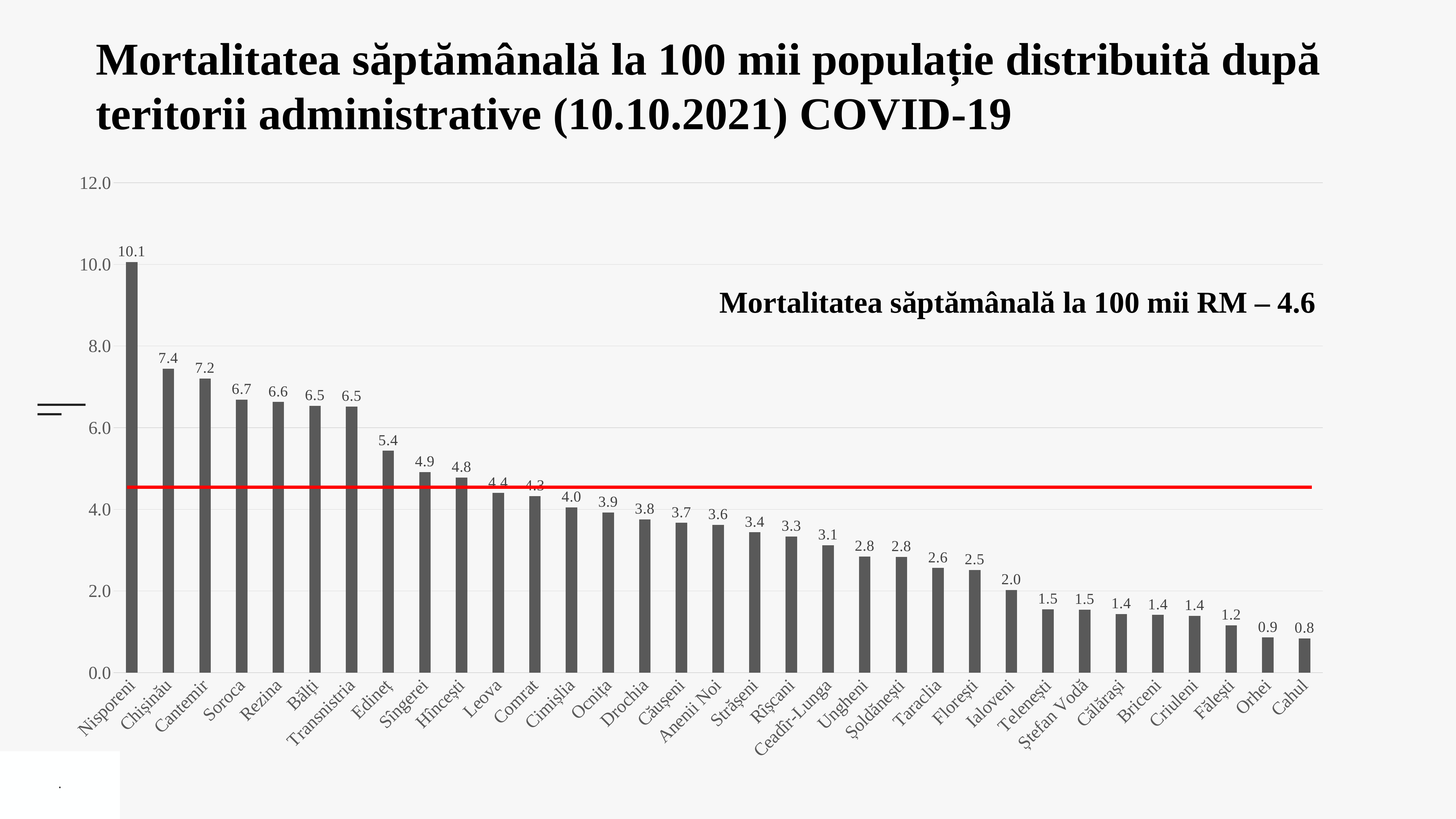
What is the value shown for Chișinău? 7.4 Which territory has the highest weekly mortality? Nisporeni What is the difference between the values for Nisporeni and Chișinău? 2.7 What is the value shown for Edineț? 5.4 Do the values rise or fall from left to right along the x axis? Fall What is the weekly mortality value for Nisporeni? 10.1 Which territory has the lowest weekly mortality? Cahul How many territories are shown on the chart? 33 What value does the red horizontal line represent, according to the text on the slide? 4.6 Which has a higher value, Soroca or Drochia? Soroca What is the value shown for Ungheni? 2.8 What kind of chart is shown on the slide? Bar chart